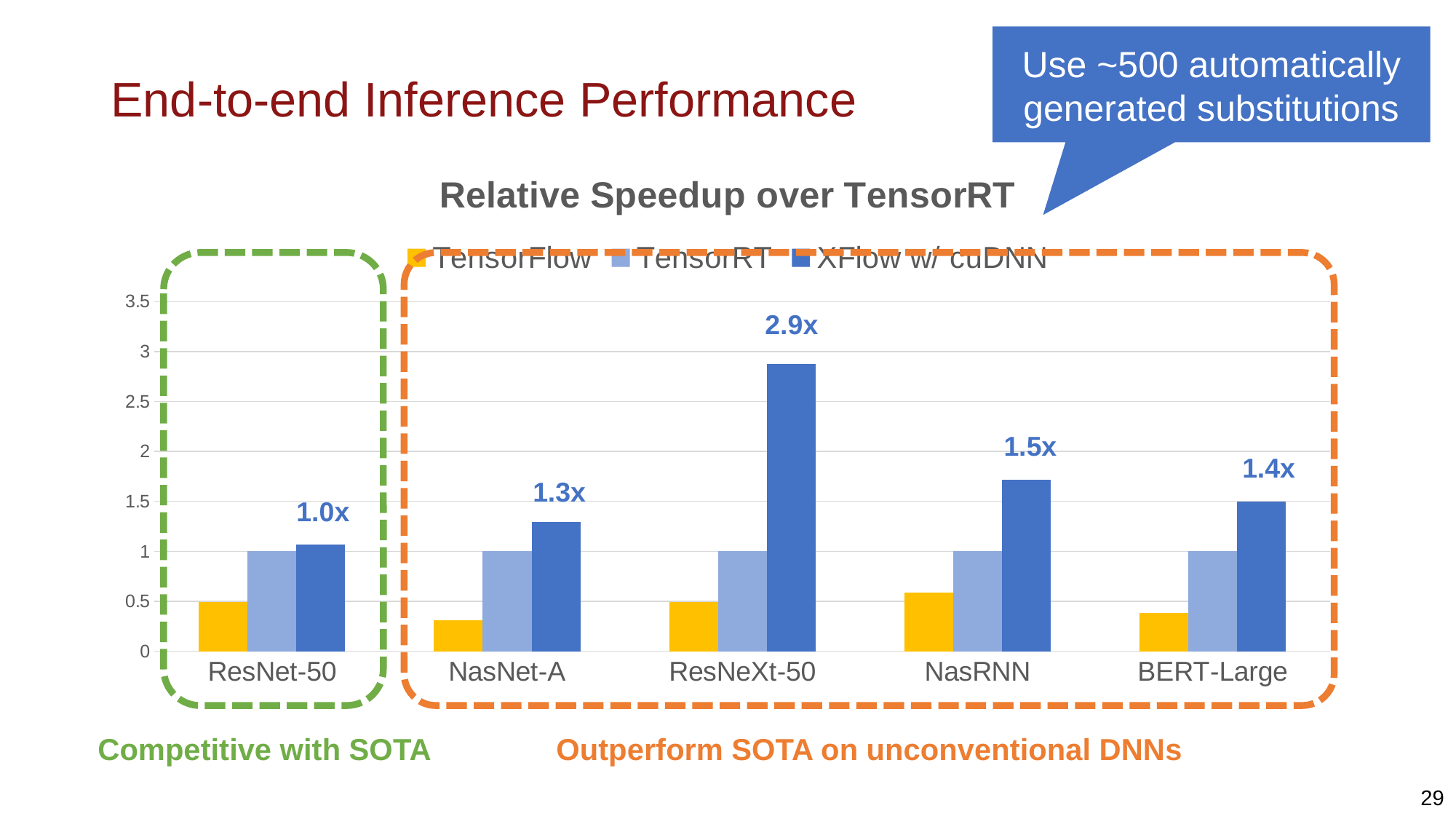
Which model has the highest XFlow w/ cuDNN speedup? ResNeXt-50 What kind of chart is shown? bar chart What is the title of the chart? Relative Speedup over TensorRT What is the XFlow w/ cuDNN speedup for ResNeXt-50? 2.9x Is the TensorFlow value for NasNet-A greater or less than 0.5? less What is the XFlow w/ cuDNN speedup for NasRNN? 1.5x Which model has the lowest XFlow w/ cuDNN speedup? ResNet-50 What is the difference between the XFlow w/ cuDNN speedup for ResNeXt-50 and for NasNet-A? 1.6x How many models are shown on the x axis? 5 What is the XFlow w/ cuDNN speedup for BERT-Large? 1.4x How many series does the legend list? 3 Which has a larger XFlow w/ cuDNN speedup, NasRNN or BERT-Large? NasRNN